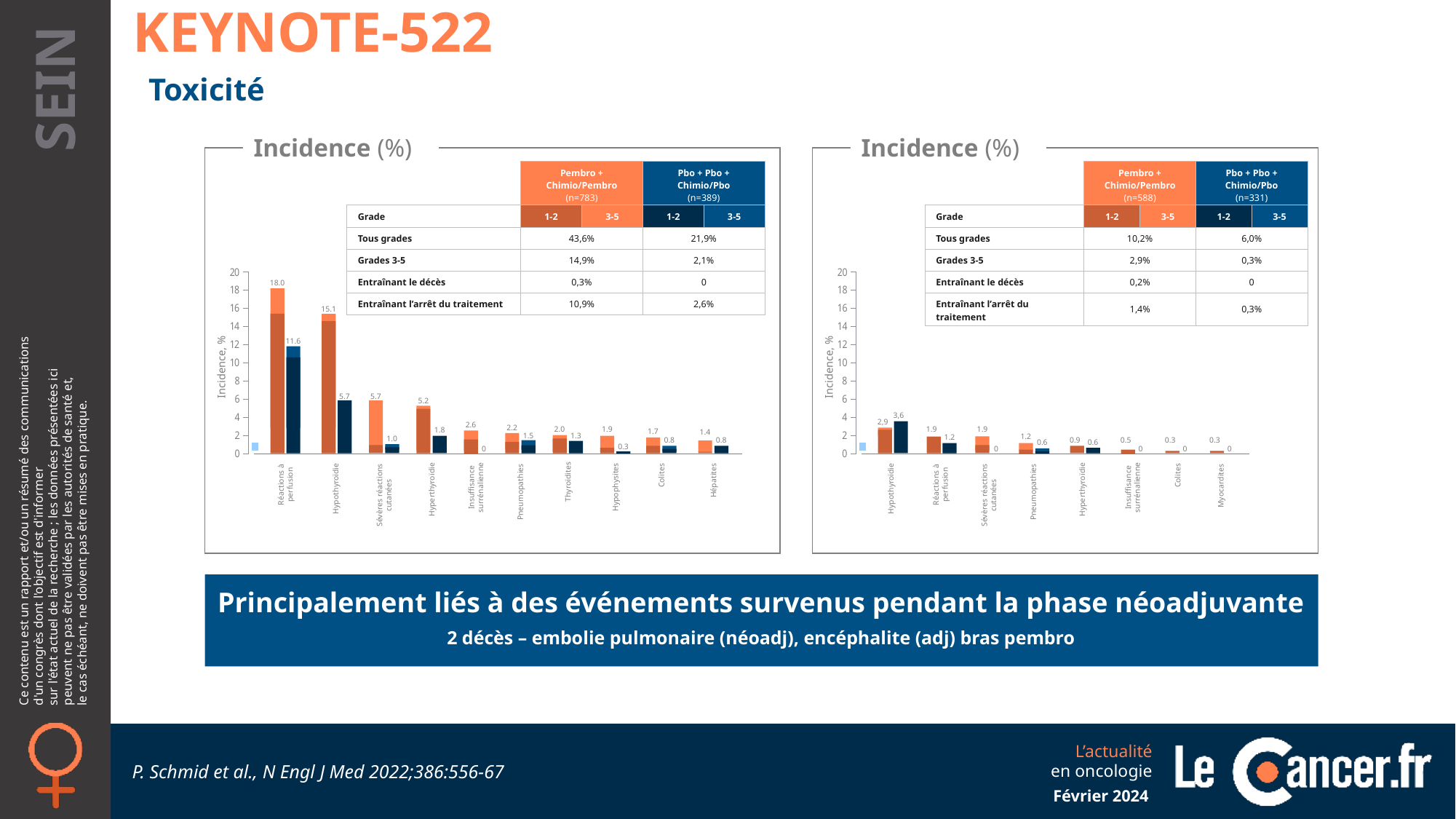
On the left chart, what is the value labelled on the orange (Pembro + Chimio/Pembro) bar for Réactions à perfusion? 18.0 On the right chart, what is the value labelled on the dark blue (Pbo + Chimio/Pbo) bar for Hypothyroïdie? 3,6 What type of chart is used on the left side of the slide? bar chart On the right chart, which category has the highest dark blue (Pbo + Chimio/Pbo) bar? Hypothyroïdie On the right chart, which is larger for Hypothyroïdie: the orange (Pembro) bar or the dark blue (Pbo) bar? the dark blue (Pbo) bar On the left chart, what is the difference between the orange and dark blue bars for Réactions à perfusion? 6.4 On the left chart, is the orange bar for Réactions à perfusion greater or less than 16? greater On the left chart, what is the difference between the orange bars for Hypothyroïdie and Hyperthyroïdie? 9.9 How many categories are shown on the x axis of the left chart? 10 On the left chart, which category has the highest orange (Pembro + Chimio/Pembro) bar? Réactions à perfusion On the left chart, what is the value labelled on the dark blue (Pbo + Chimio/Pbo) bar for Hypothyroïdie? 5.7 How many categories are shown on the x axis of the right chart? 8